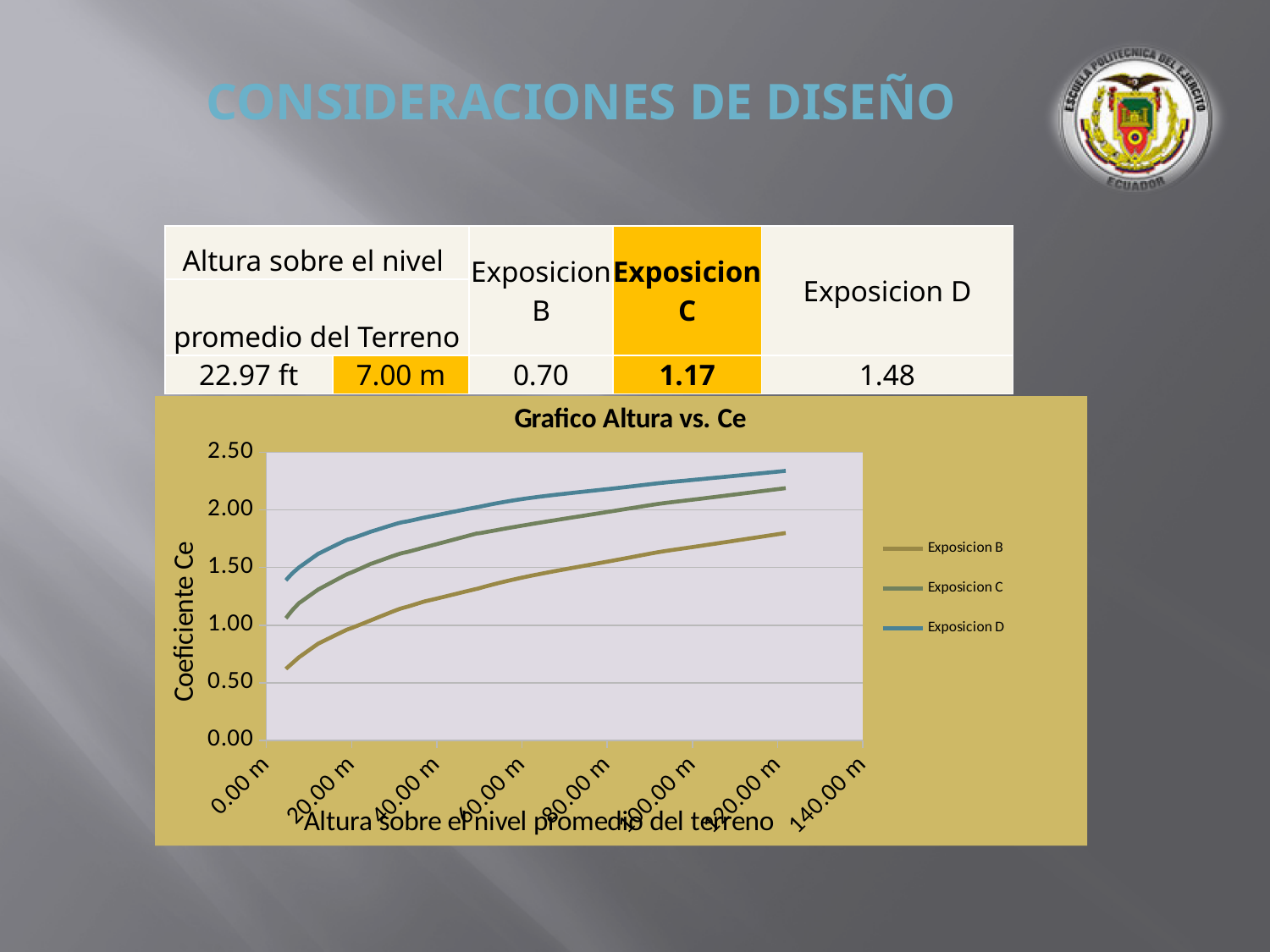
How many series does the legend of the chart list? 3 Do the values of the Exposicion B series rise or fall as the height increases along the x axis? rise Which series has the highest values across the chart? Exposicion D Which series has the lowest values across the chart? Exposicion B What is the title of the chart? Grafico Altura vs. Ce At 120.00 m, is the value for Exposicion C larger or smaller than the value for Exposicion B? larger What kind of chart is shown on the slide? line chart Is the value for Exposicion D at 120.00 m greater or less than 2.00? greater Is the value for Exposicion C at 0.00 m greater or less than 1.50? less What is the label of the vertical axis of the chart? Coeficiente Ce Is the value for Exposicion B at 120.00 m greater or less than 1.50? greater